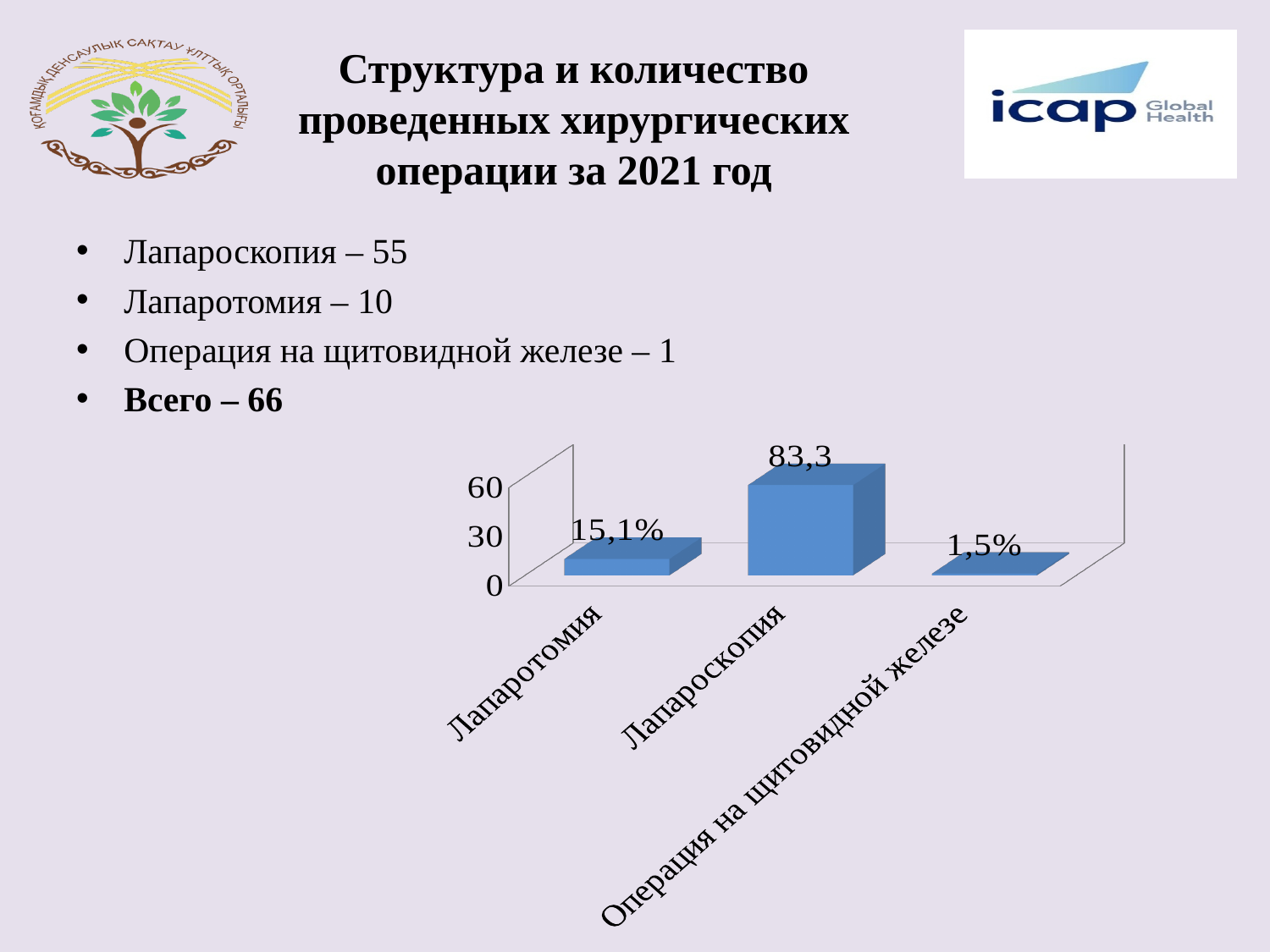
Is the value for Лапаротомия greater or less than 30? less What kind of chart is shown on the slide? bar chart What value is shown for Лапароскопия in the chart? 83,3 What is the highest tick label shown on the vertical axis of the chart? 60 What value is shown for Лапаротомия in the chart? 15,1% Which category has the highest bar in the chart? Лапароскопия Which category has the lowest bar in the chart? Операция на щитовидной железе How many categories are plotted in the chart? 3 What value is shown for Операция на щитовидной железе in the chart? 1,5% Which is larger in the chart, the value for Лапаротомия or the value for Операция на щитовидной железе? Лапаротомия